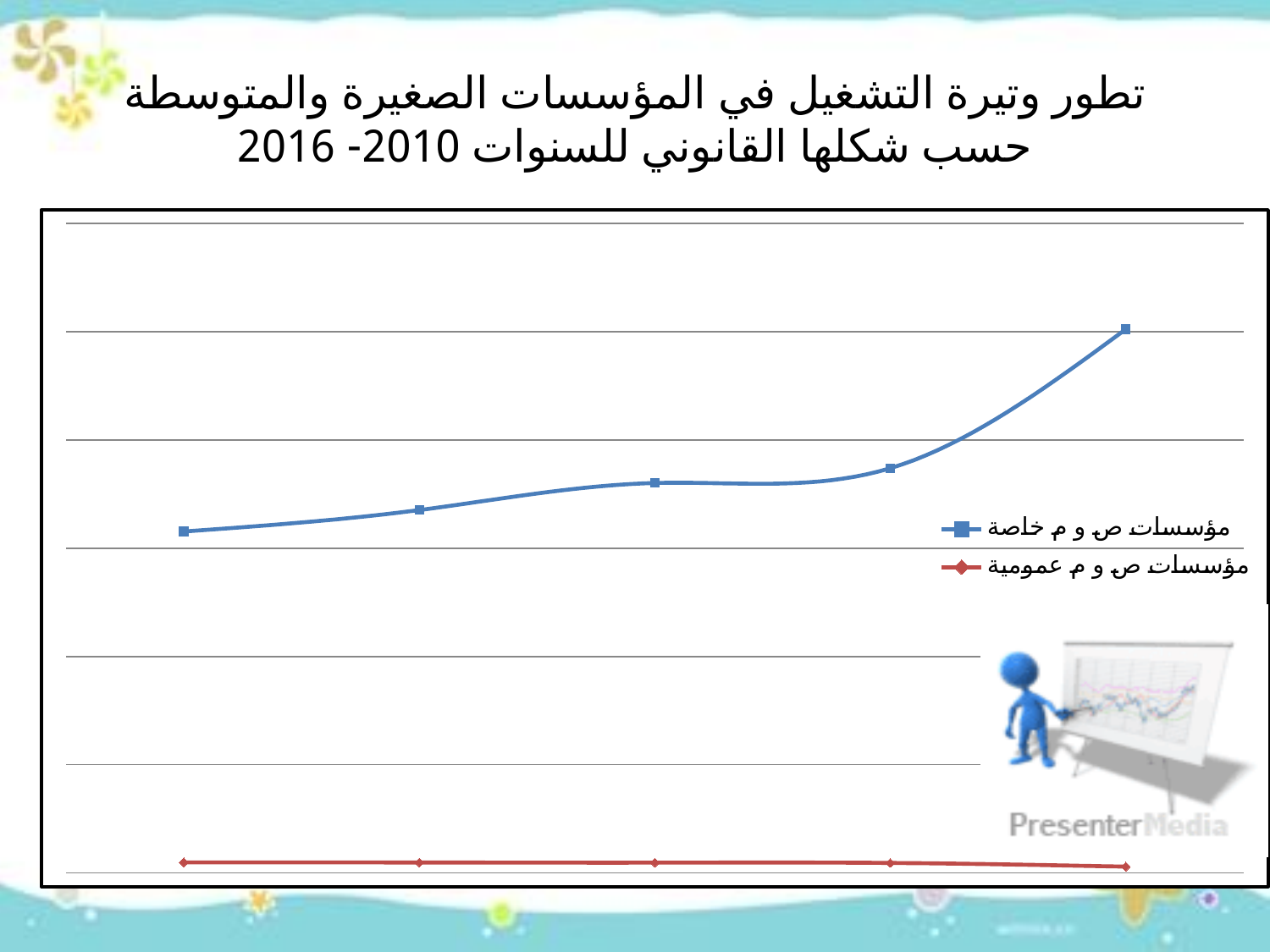
Which series has the higher values throughout the chart, مؤسسات ص و م خاصة or مؤسسات ص و م عمومية? مؤسسات ص و م خاصة Which series is plotted with the blue line? مؤسسات ص و م خاصة At which point along the x axis does the series مؤسسات ص و م خاصة have its lowest value, the first or the last? The first Which series is plotted with the red line? مؤسسات ص و م عمومية At which point along the x axis does the series مؤسسات ص و م خاصة reach its highest value, the first or the last? The last How many data points are plotted for the series مؤسسات ص و م عمومية? 5 Do the values for مؤسسات ص و م خاصة rise or fall from left to right along the x axis? Rise What kind of chart is shown on the slide? Line chart How many data points are plotted for the series مؤسسات ص و م خاصة? 5 How many series does the legend list? 2